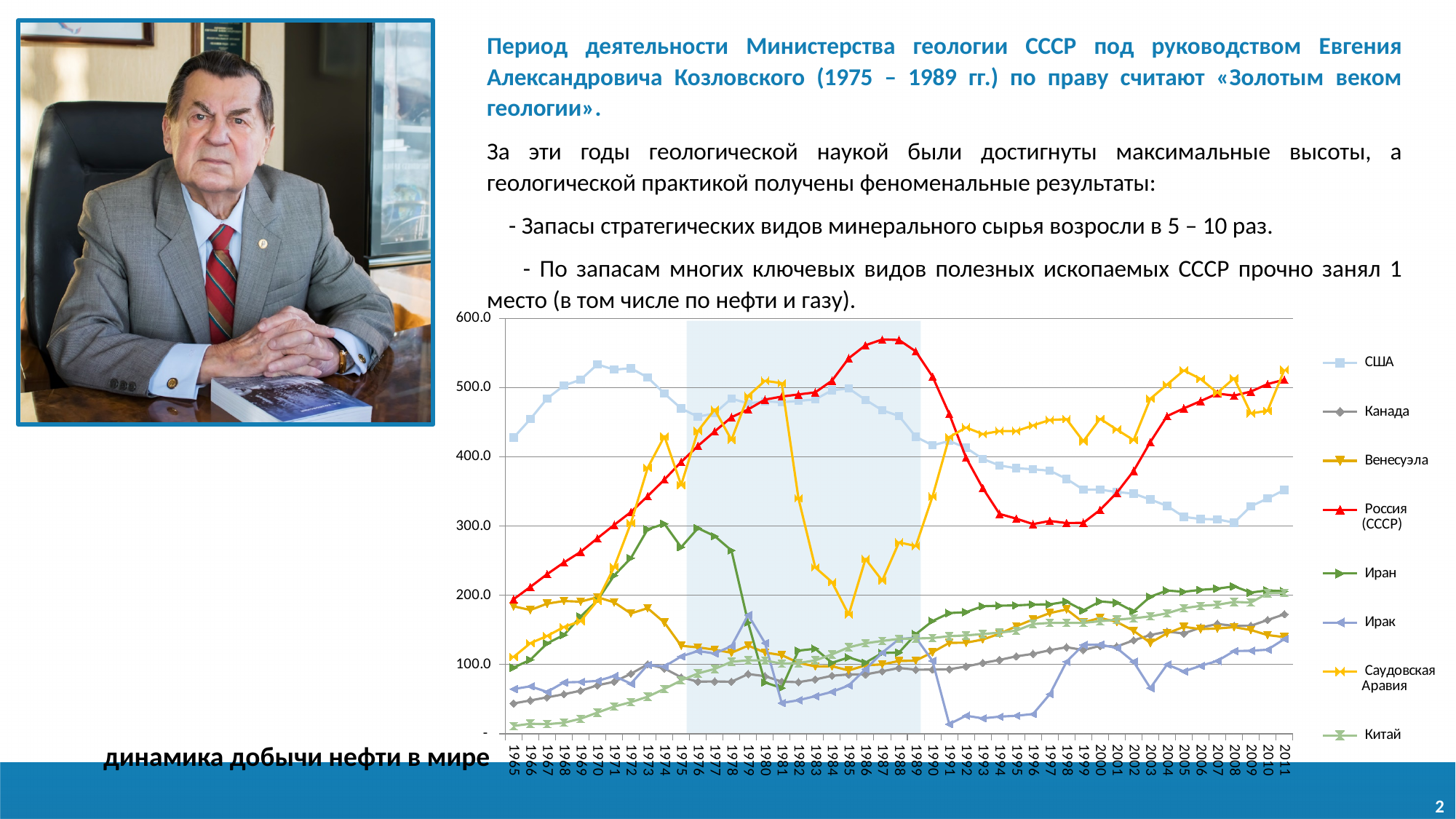
Which series has the highest value in 1987? Россия (СССР) What is the title of the chart? динамика добычи нефти в мире Which series has the lowest value in 1965? Китай How many series does the chart legend list? 8 Is the value for Россия (СССР) in 1987 greater or less than 500? greater What kind of chart is shown on the slide? line chart Does the value for Китай rise or fall from 1965 to 2011? rise How many years are plotted along the x axis of the chart? 47 Is the value for Ирак in 1991 greater or less than 100? less In 2011, which is larger: the value for Иран or the value for Ирак? Иран Is the value for Саудовская Аравия in 2005 greater or less than 500? greater